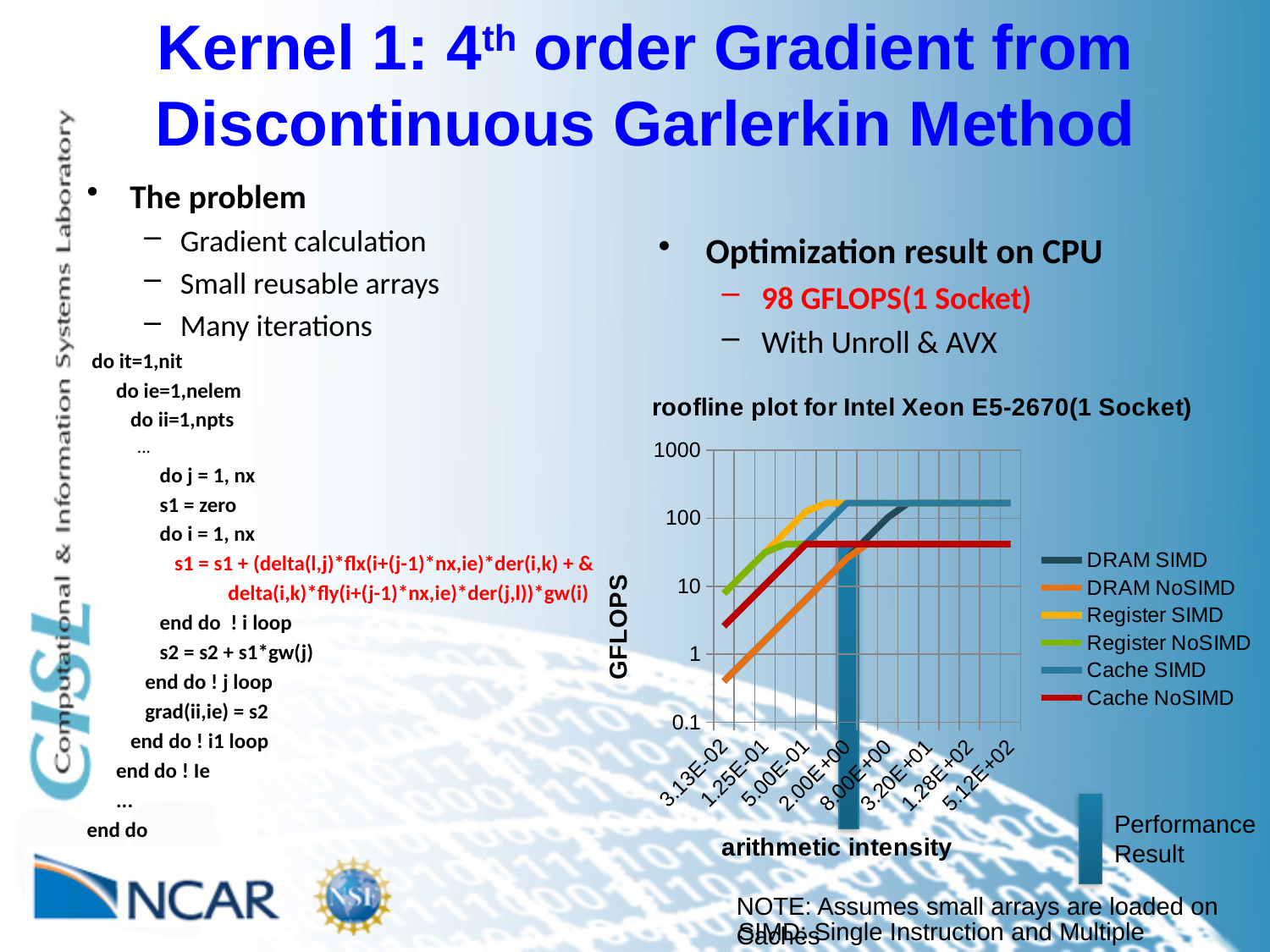
What is the label of the y axis of the roofline plot? GFLOPS In the roofline plot, do the DRAM SIMD values rise or fall as arithmetic intensity increases from 3.13E-02 to 2.00E+00? rise In the roofline plot, which reaches a higher plateau: Cache SIMD or Cache NoSIMD? Cache SIMD What kind of chart is the roofline plot? line chart How many tick labels are shown on the arithmetic intensity axis of the roofline plot? 8 What is the title of the chart on the slide? roofline plot for Intel Xeon E5-2670(1 Socket) In the roofline plot, is the Performance Result bar greater or less than 10 GFLOPS? greater In the roofline plot, is the plateau value of the Cache NoSIMD line greater or less than 100 GFLOPS? less In the roofline plot, is the DRAM NoSIMD value at arithmetic intensity 3.13E-02 greater or less than 1 GFLOPS? less How many series does the legend of the roofline plot list? 6 In the roofline plot, which reaches a higher plateau: Register SIMD or Register NoSIMD? Register SIMD